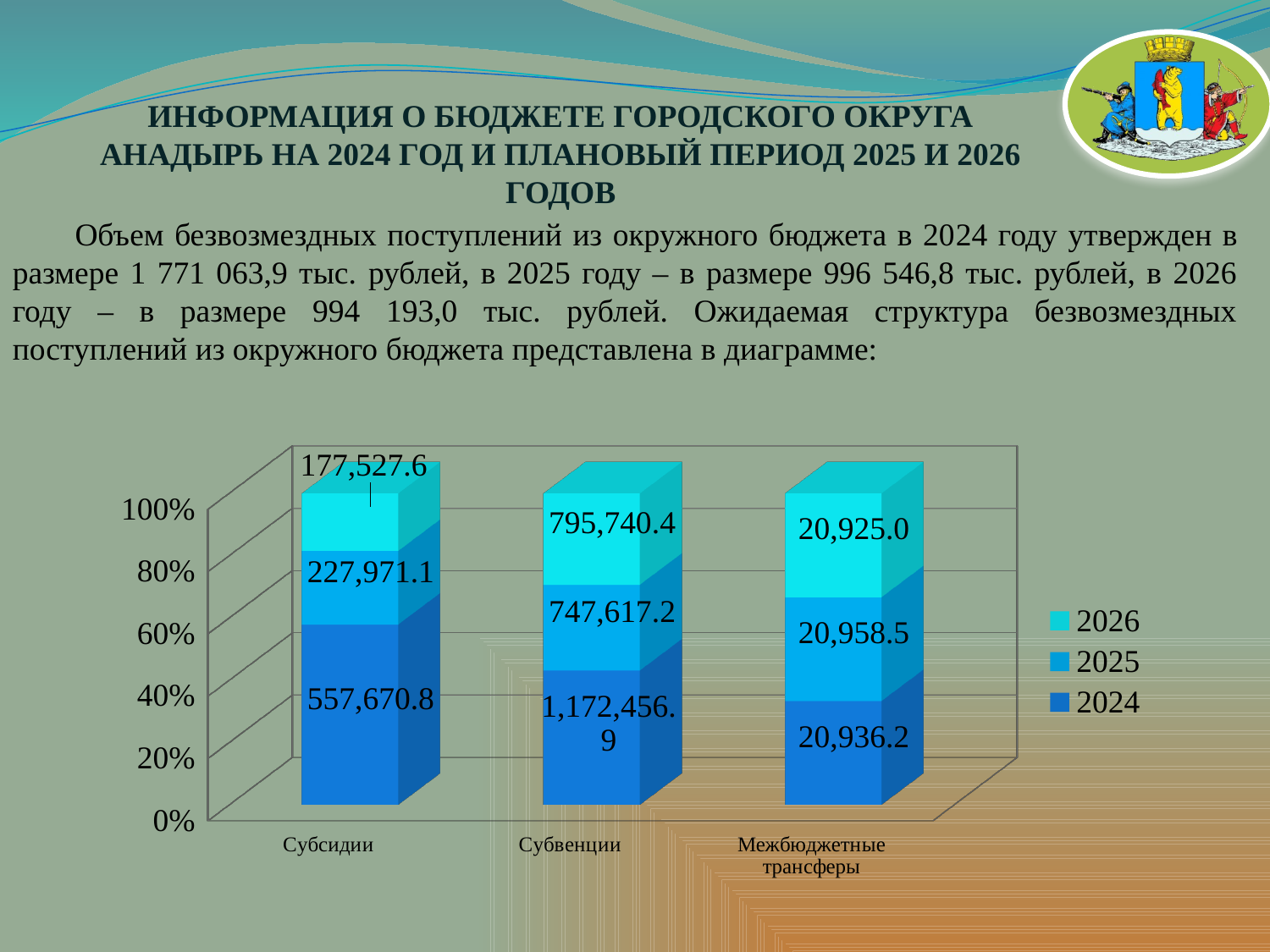
Which is larger for Субвенции: the 2025 value or the 2026 value? 2026 What is the total of the three values stacked in the Межбюджетные трансферы bar? 62,819.7 What is the value for 2025 in the Межбюджетные трансферы category? 20,958.5 Which category has the lowest value for the 2026 series? Межбюджетные трансферы How many categories are shown on the x axis? 3 What kind of chart is shown on the slide? Stacked bar chart What is the value for 2024 in the Субсидии category? 557,670.8 How many series does the legend list? 3 Which category has the highest value for the 2024 series? Субвенции What is the value for 2026 in the Субвенции category? 795,740.4 Which series is shown in the darkest blue colour according to the legend? 2024 What is the difference between the 2024 and 2025 values for Субсидии? 329,699.7